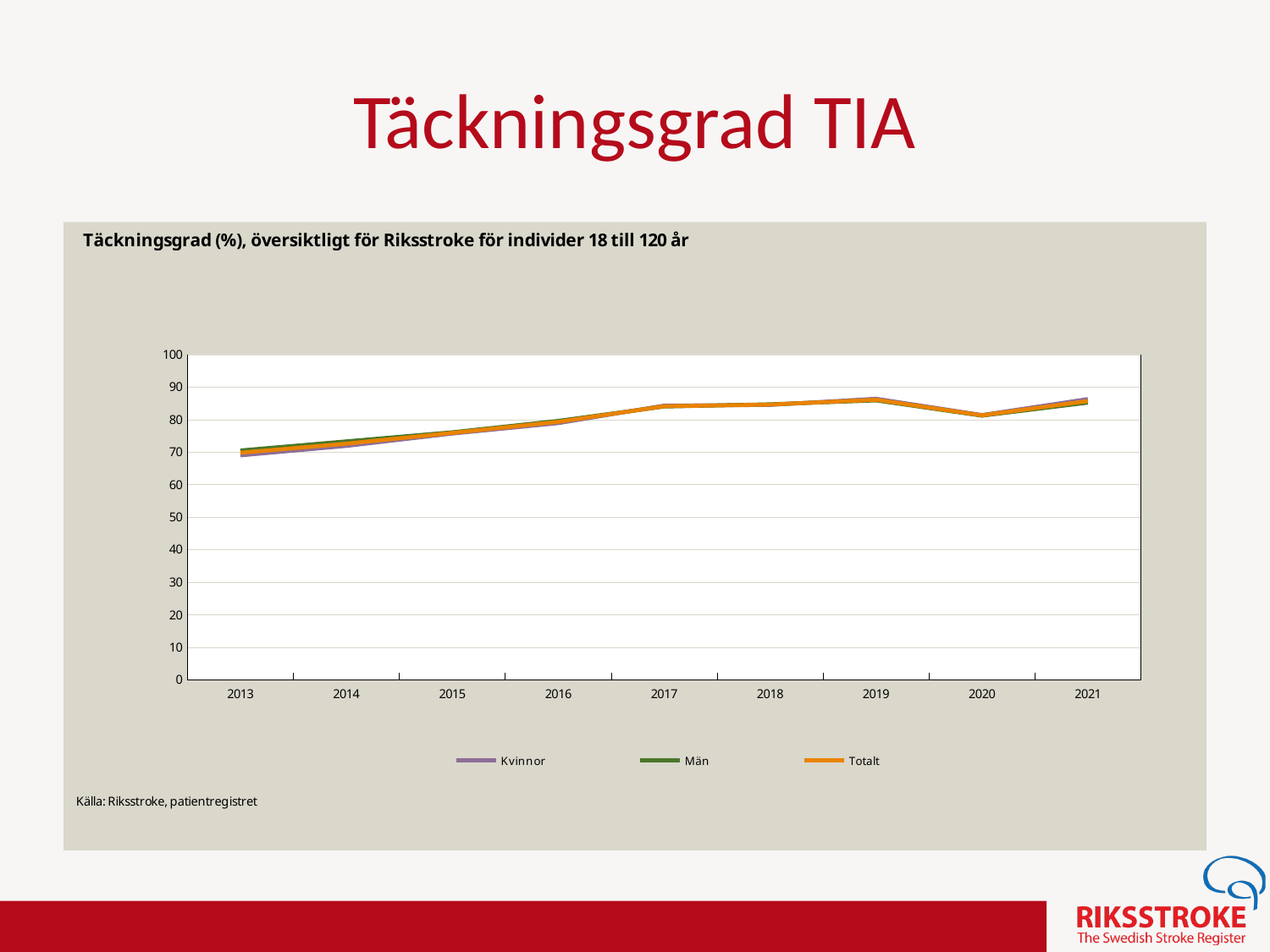
What is the title printed inside the chart area? Täckningsgrad (%), översiktligt för Riksstroke för individer 18 till 120 år Is the value for Totalt in 2019 greater or less than 80? greater What are the names of the three series in the legend? Kvinnor, Män, Totalt Do the Totalt values rise or fall from 2013 to 2019? rise Is the value for Kvinnor in 2017 greater or less than 90? less Is the value for Totalt in 2013 greater or less than 60? greater What kind of chart is shown on the slide? line chart How many years are shown on the x axis? 9 In which year is the Totalt value lowest? 2013 How many series does the legend list? 3